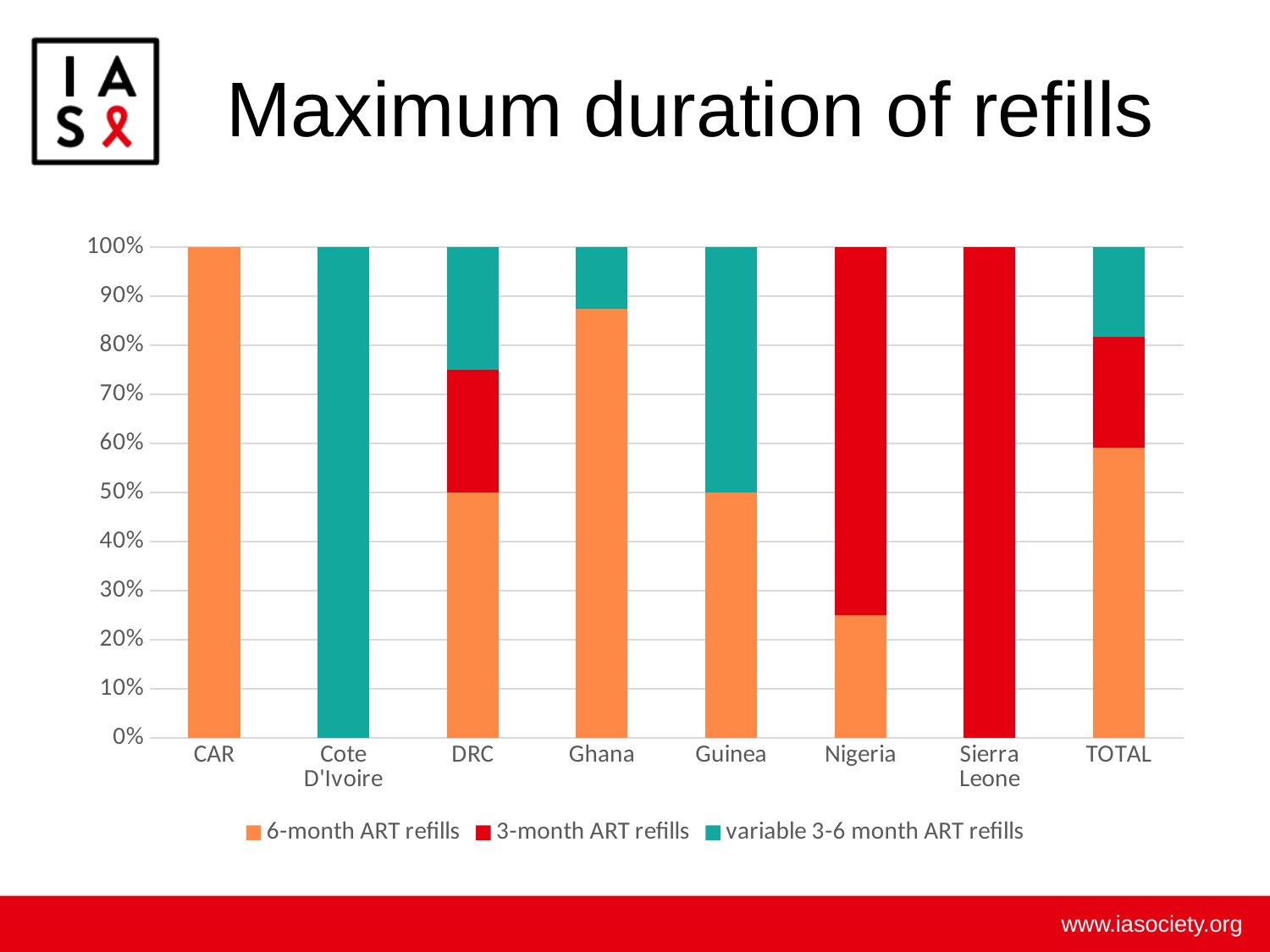
What is the value for 6-month ART refills for DRC? 50% What is the value for 6-month ART refills for CAR? 100% Is the value for 6-month ART refills for TOTAL greater or less than 50%? greater What is the value for 3-month ART refills for Sierra Leone? 100% What is the value for variable 3-6 month ART refills for Cote D'Ivoire? 100% How many series does the legend list? 3 How many categories are shown along the x axis? 8 What is the title of the slide? Maximum duration of refills What is the value for 6-month ART refills for Guinea? 50% What kind of chart is shown on the slide? Stacked bar chart Is the value for 6-month ART refills for Ghana greater or less than 80%? greater Is the value for 6-month ART refills for Nigeria greater or less than 30%? less